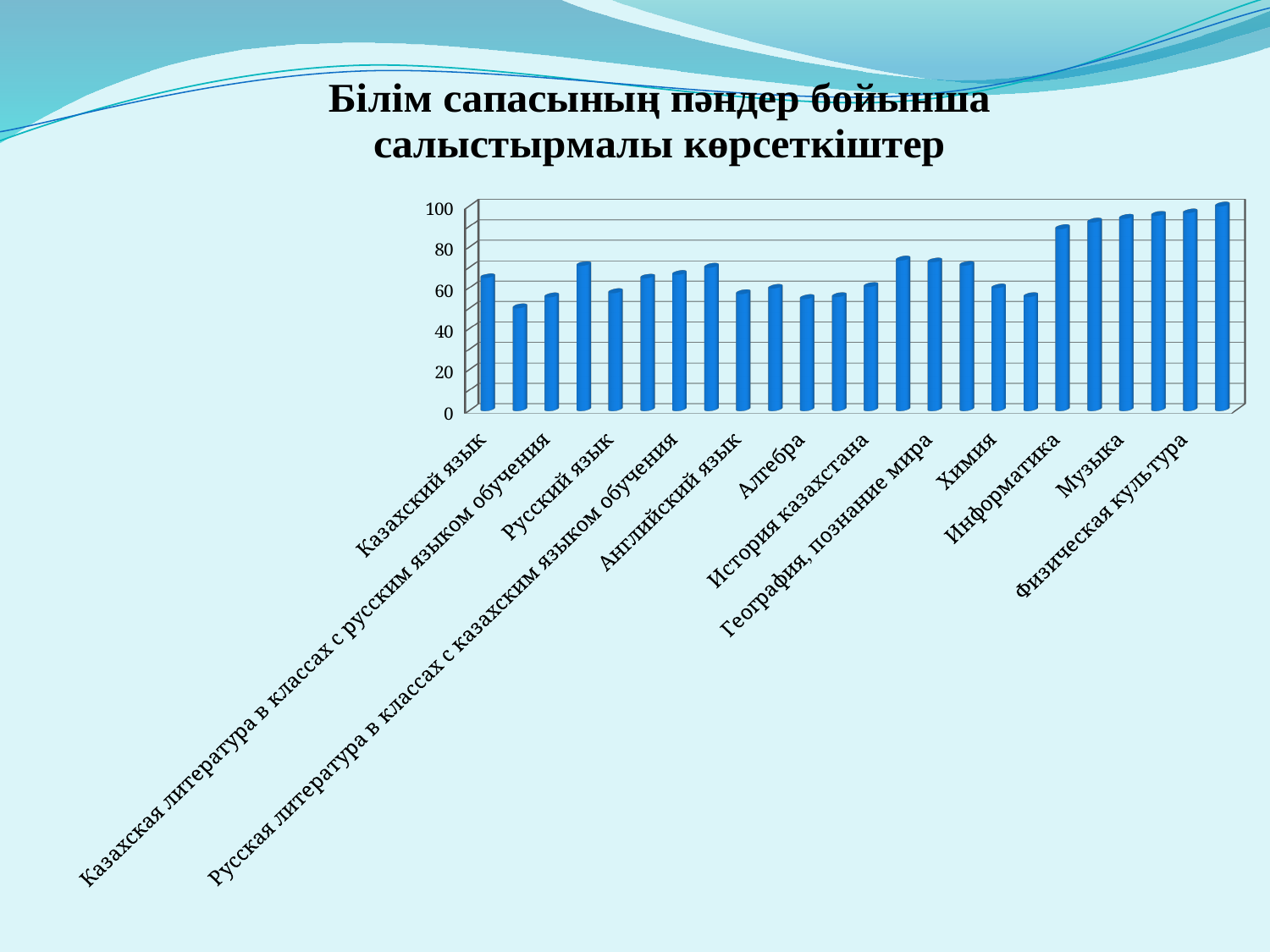
What is the title of the slide above the chart? Білім сапасының пәндер бойынша салыстырмалы көрсеткіштер Is the value for Алгебра greater or less than 80? less Is the value for Химия greater or less than 40? greater Are the bars at the right end of the chart (Информатика, Музыка, Физическая культура) higher or lower than the bars at the left end? higher Is the value for Казахская литература в классах с русским языком обучения greater or less than 80? less Which has the larger value, Музыка or Алгебра? Музыка What is the highest value shown on the vertical axis of the chart? 100 Which has the larger value, Информатика or Казахский язык? Информатика What kind of chart is shown on the slide? bar chart